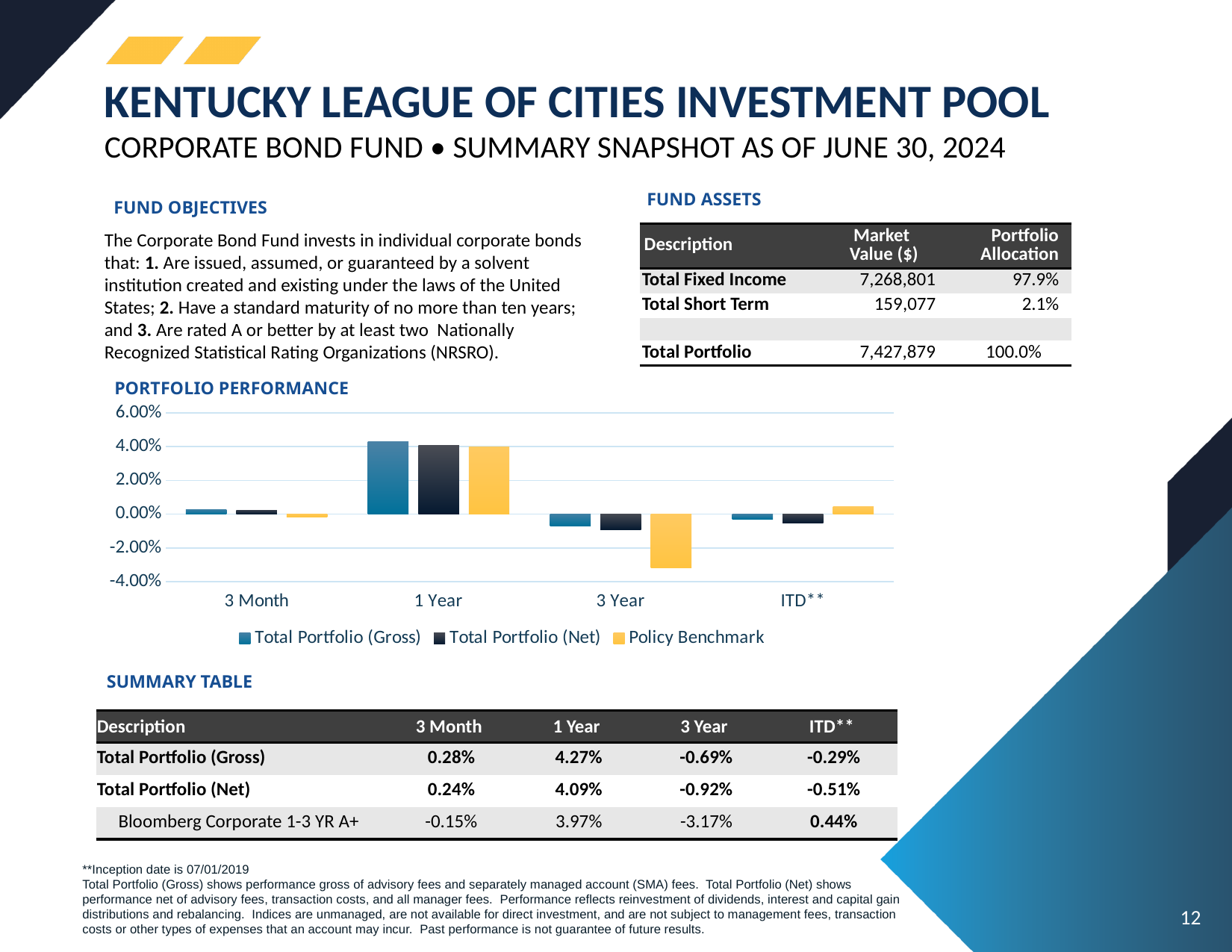
What is the difference between the 1 Year values of Total Portfolio (Gross) and Total Portfolio (Net) shown on the slide? 0.18% In the Portfolio Performance chart, which period has the lowest Policy Benchmark value? 3 Year In the Portfolio Performance chart, is the Policy Benchmark value for 3 Year greater or less than -2.00%? less According to the slide, what is the 3 Month value for Total Portfolio (Gross)? 0.28% How many series does the legend of the Portfolio Performance chart list? 3 In the Portfolio Performance chart, is the Total Portfolio (Gross) value for 1 Year greater or less than 4.00%? greater According to the slide, what is the 3 Year value for Total Portfolio (Net)? -0.92% In the Portfolio Performance chart, which period has the highest Total Portfolio (Gross) value? 1 Year What kind of chart is shown under Portfolio Performance? bar chart In the Portfolio Performance chart, for 1 Year, which is larger: Total Portfolio (Gross) or Policy Benchmark? Total Portfolio (Gross) What are the three legend entries of the Portfolio Performance chart? Total Portfolio (Gross), Total Portfolio (Net), Policy Benchmark How many time periods are shown on the x axis of the Portfolio Performance chart? 4